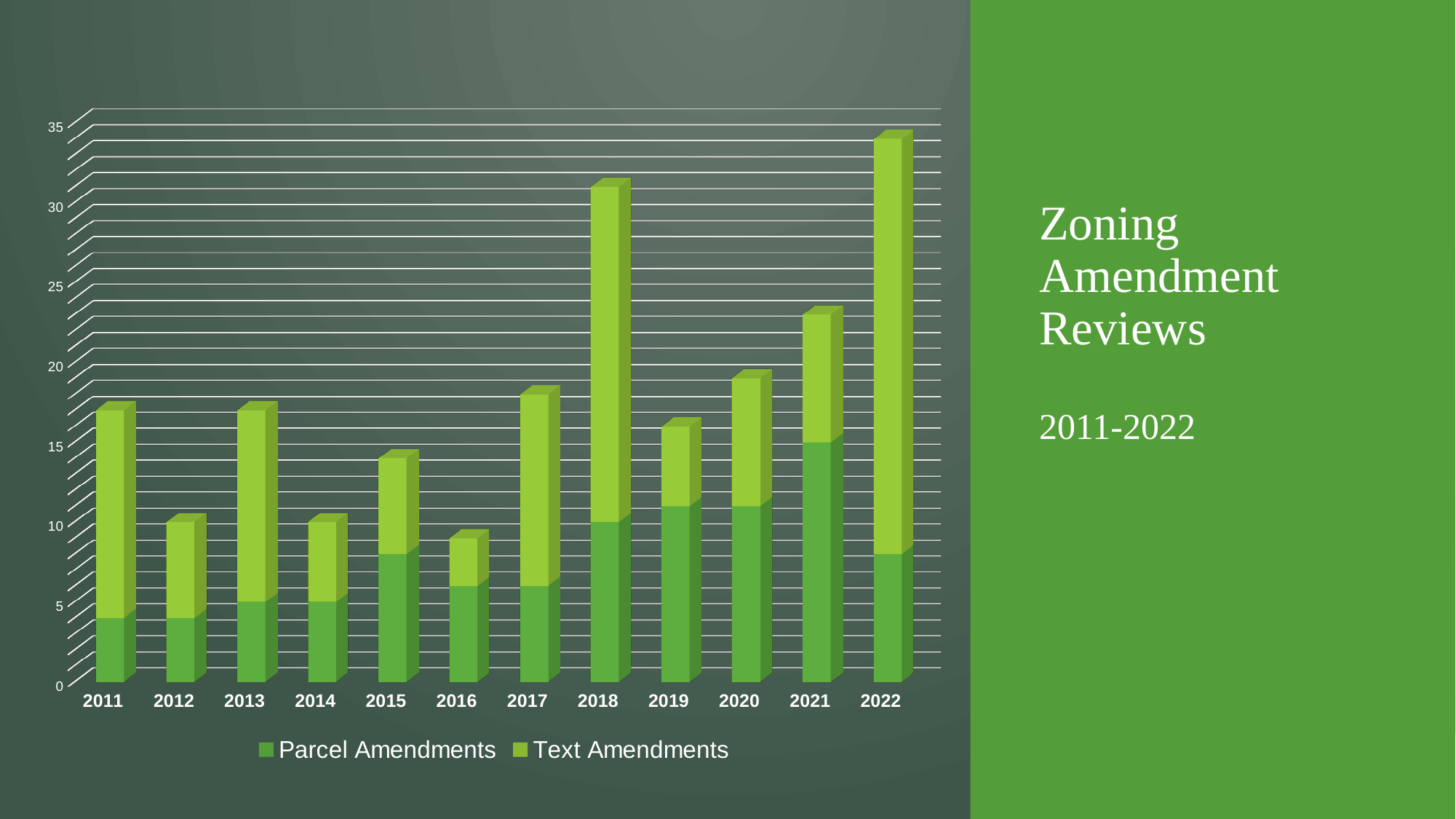
What are the two series named in the chart legend? Parcel Amendments and Text Amendments Is the total bar for 2022 greater or less than 30? greater How many years are shown on the x axis of the chart? 12 How many series does the chart legend list? 2 Which year has the lowest total bar in the chart? 2016 What kind of chart is shown on the slide? Stacked bar chart Do the total bars rise or fall from 2019 to 2022? rise Is the total bar for 2016 greater or less than 15? less Which year has the taller total bar, 2018 or 2021? 2018 Which year has the largest Parcel Amendments segment? 2021 Which year has the highest total bar in the chart? 2022 Is the total bar for 2021 greater or less than 20? greater